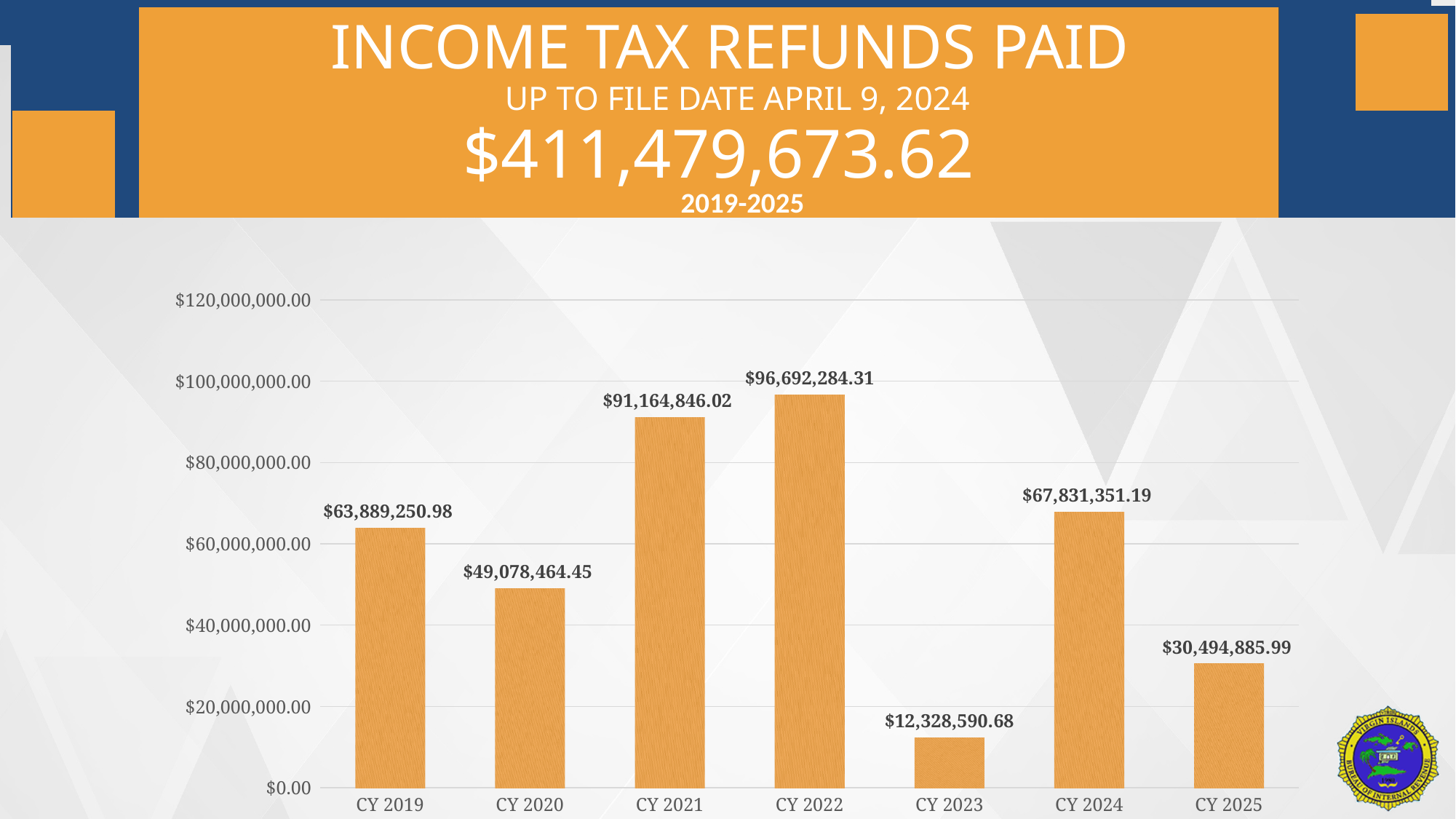
What is the value for CY 2022? $96,692,284.31 Do the values rise or fall from CY 2020 to CY 2022? rise Which year has the highest value? CY 2022 What is the difference between the values for CY 2024 and CY 2025? $37,336,465.20 What is the value for CY 2023? $12,328,590.68 How many years are shown on the x axis? 7 What is the value for CY 2025? $30,494,885.99 What kind of chart is shown on the slide? bar chart Which is larger, the value for CY 2019 or the value for CY 2024? CY 2024 Which year has the lowest value? CY 2023 What is the difference between the values for CY 2022 and CY 2021? $5,527,438.29 Is the value for CY 2020 greater or less than $60,000,000.00? less